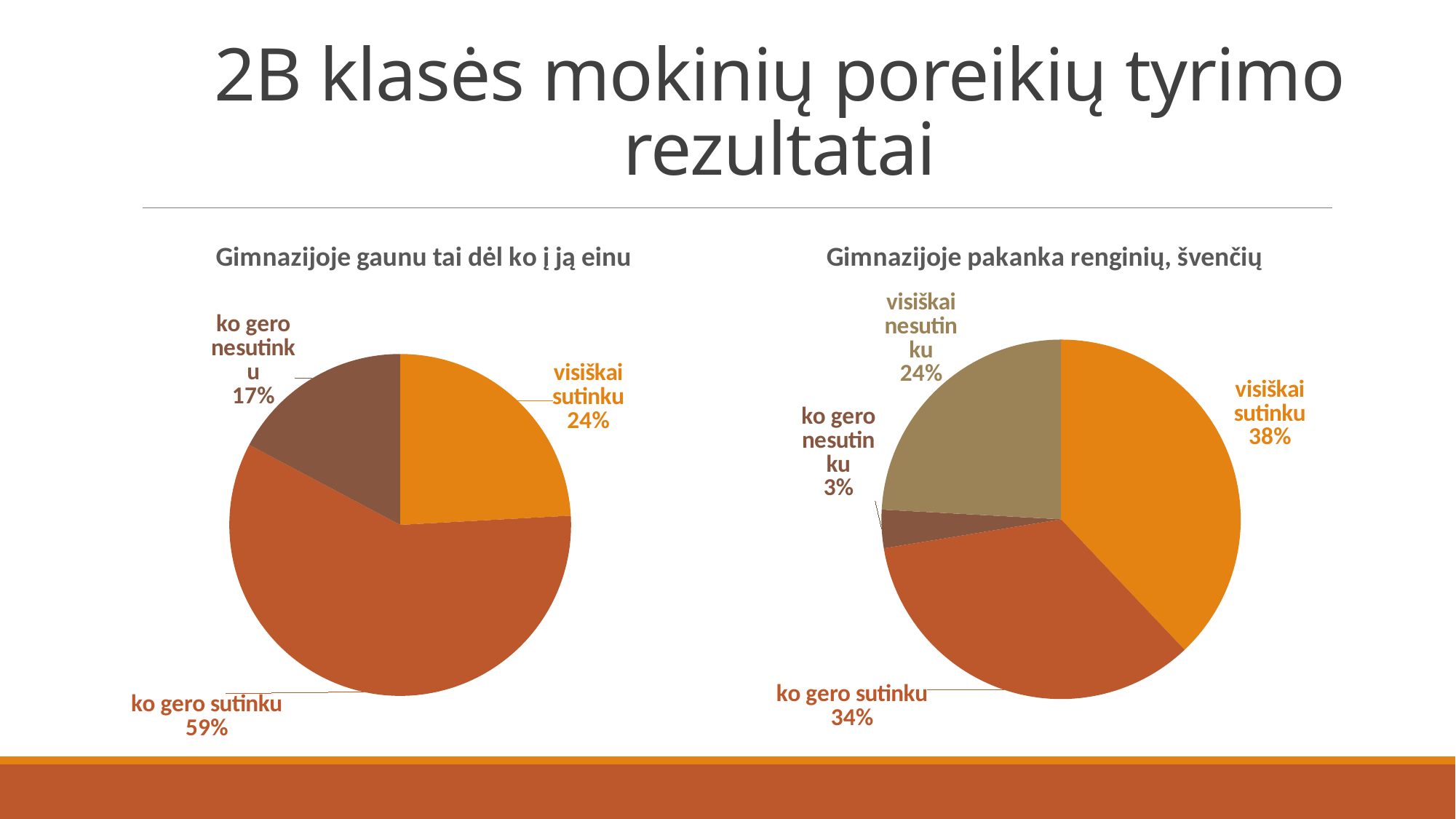
In the chart titled "Gimnazijoje pakanka renginių, švenčių", what is the difference between "visiškai sutinku" and "ko gero sutinku"? 4% In the chart titled "Gimnazijoje gaunu tai dėl ko į ją einu", what share does "ko gero sutinku" have? 59% In the chart titled "Gimnazijoje gaunu tai dėl ko į ją einu", what share does "visiškai sutinku" have? 24% In the chart titled "Gimnazijoje pakanka renginių, švenčių", which category has the smallest slice? ko gero nesutinku In the chart titled "Gimnazijoje gaunu tai dėl ko į ją einu", what share does "ko gero nesutinku" have? 17% In the chart titled "Gimnazijoje pakanka renginių, švenčių", what share does "ko gero nesutinku" have? 3% In the chart titled "Gimnazijoje pakanka renginių, švenčių", what share does "visiškai sutinku" have? 38% In the chart titled "Gimnazijoje gaunu tai dėl ko į ją einu", how many slices does the pie have? 3 What type of chart is the chart titled "Gimnazijoje pakanka renginių, švenčių"? Pie chart In the chart titled "Gimnazijoje gaunu tai dėl ko į ją einu", which is larger: "visiškai sutinku" or "ko gero nesutinku"? visiškai sutinku In the chart titled "Gimnazijoje gaunu tai dėl ko į ją einu", which category has the largest slice? ko gero sutinku In the chart titled "Gimnazijoje pakanka renginių, švenčių", how many slices does the pie have? 4